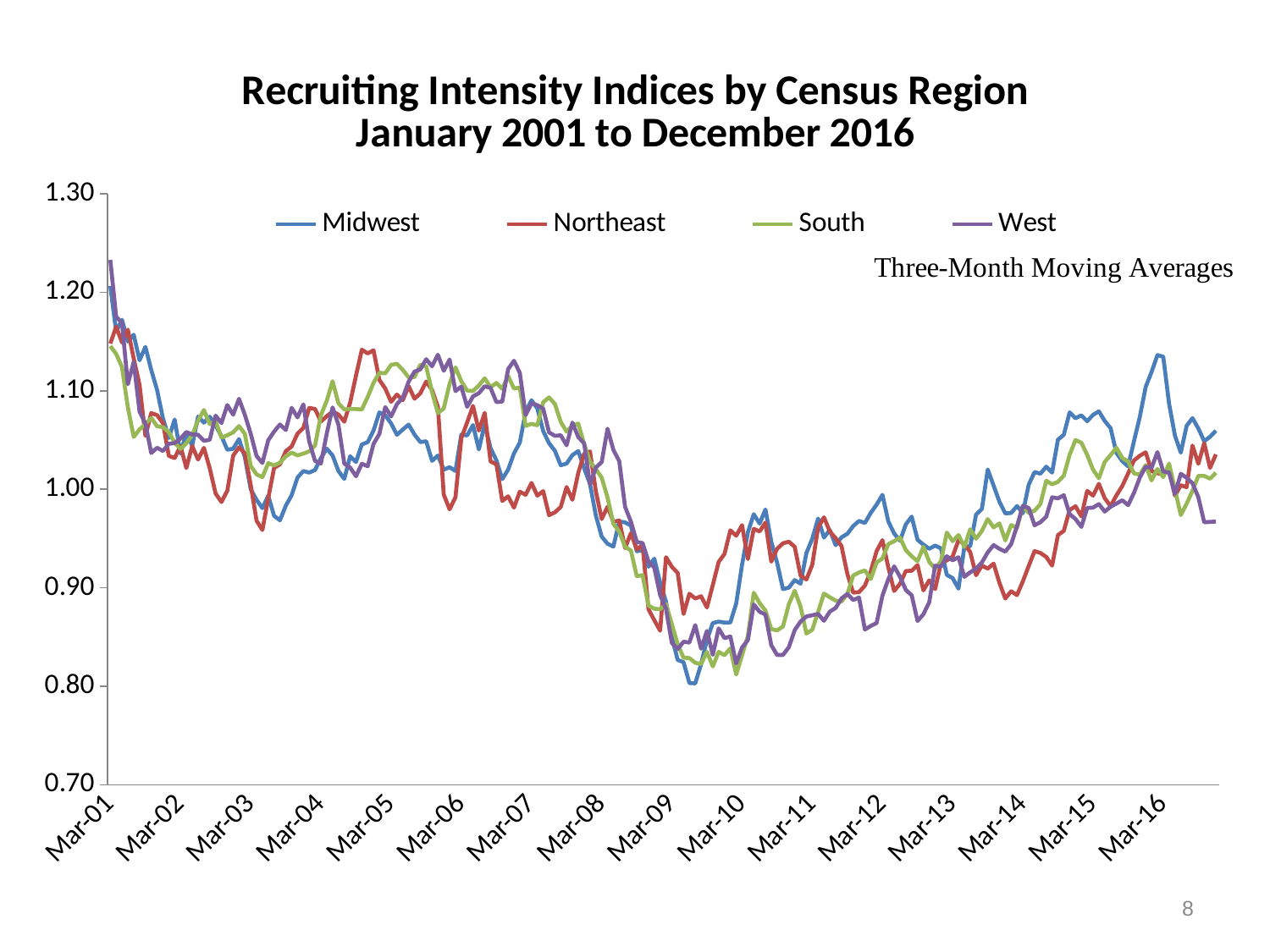
How many series does the legend list? 4 Is the peak value of the Midwest series around Mar-16 greater or less than 1.10? greater Is the value of the West series at the end of the chart (December 2016) greater or less than 1.00? less Which colour is used for the Northeast series? red At Mar-16, which series has the larger value, Midwest or West? Midwest Do the series generally rise or fall between Mar-09 and Mar-15? rise What is the title of the chart? Recruiting Intensity Indices by Census Region January 2001 to December 2016 At Mar-10, which series has the larger value, Northeast or West? Northeast Do the series generally rise or fall between Mar-07 and Mar-09? fall What kind of chart is shown on the slide? line chart Is the peak value of the Northeast series around Mar-05 greater or less than 1.10? greater